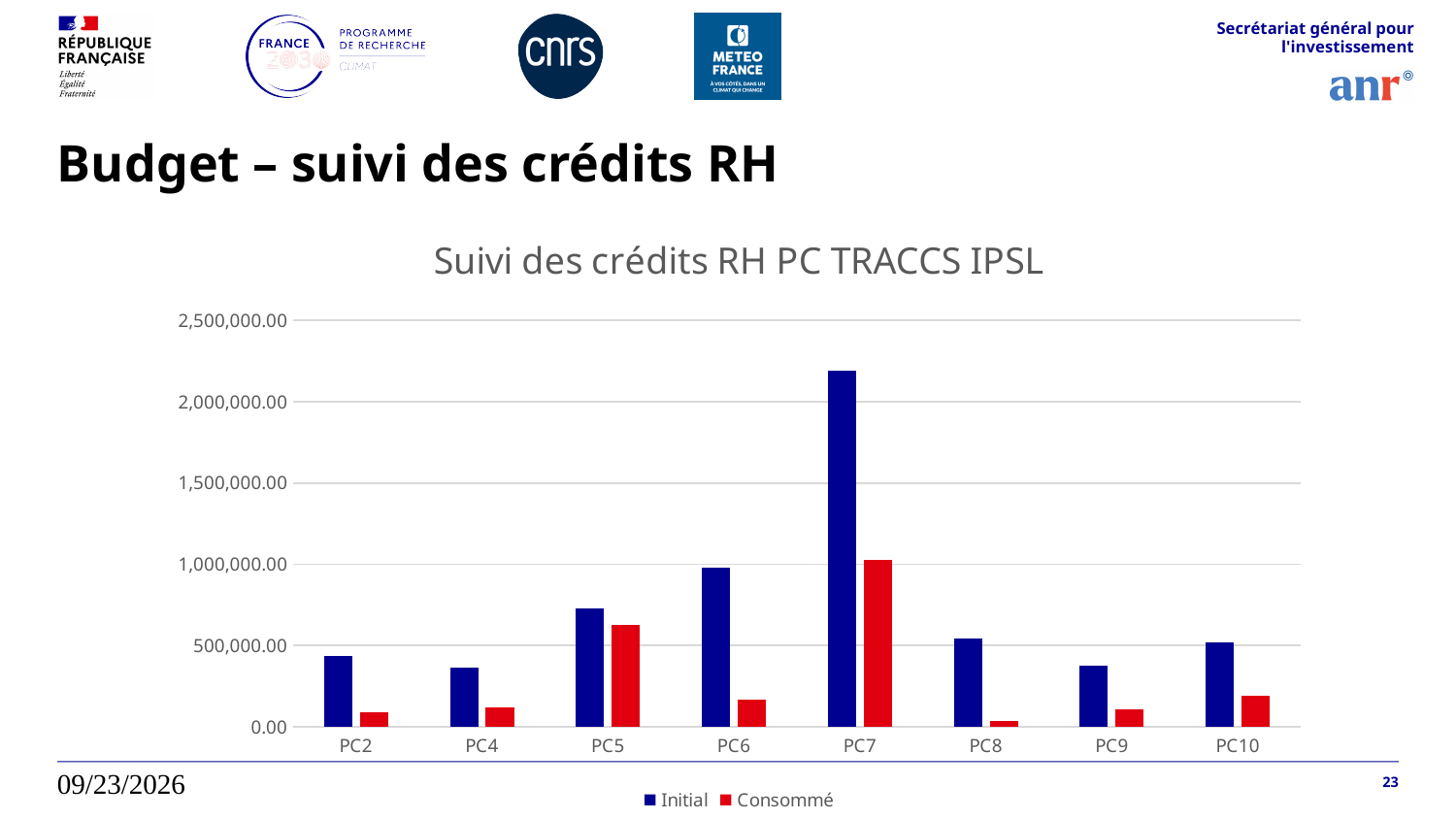
How many series does the legend list? 2 What is the title of the chart? Suivi des crédits RH PC TRACCS IPSL Is the Initial value for PC5 greater or less than 500,000.00? greater Is the Initial value for PC2 greater or less than 500,000.00? less Which category has the highest Initial value? PC7 Which category has the highest Consommé value? PC7 What type of chart is shown on the slide? bar chart Which is larger, the Initial value for PC5 or the Initial value for PC6? PC6 Is the Initial value for PC7 greater or less than 2,000,000.00? greater Which is larger, the Consommé value for PC5 or the Consommé value for PC6? PC5 How many categories are shown on the x axis? 8 Which category has the lowest Consommé value? PC8